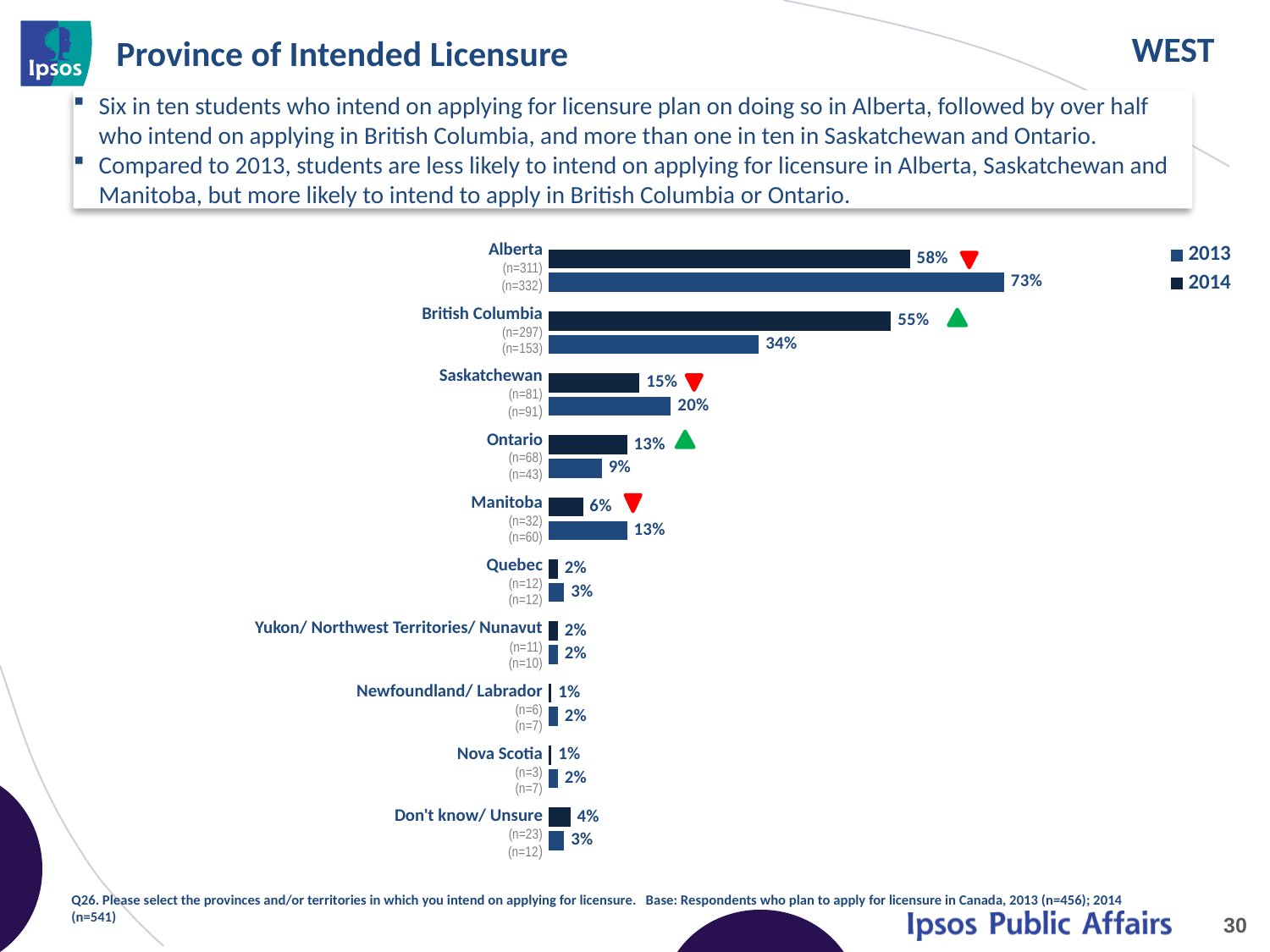
Which category has the single highest value on the chart? Alberta How many categories (provinces/territories and 'Don't know/Unsure') are plotted on the chart? 10 How many series does the chart legend list? 2 What is the value of the lower bar for British Columbia? 34% What are the two entries in the chart legend? 2013 and 2014 What is the value of the upper bar for Alberta? 58% What is the value of the upper bar for Don't know/ Unsure? 4% What is the difference between the two bars for Alberta (73% and 58%)? 15 percentage points What kind of chart is shown on the slide? Bar chart What is the value of the lower bar for Manitoba? 13% Which is larger: the upper bar for Saskatchewan or the upper bar for Ontario? Saskatchewan What is the difference between the two bars for British Columbia (55% and 34%)? 21 percentage points